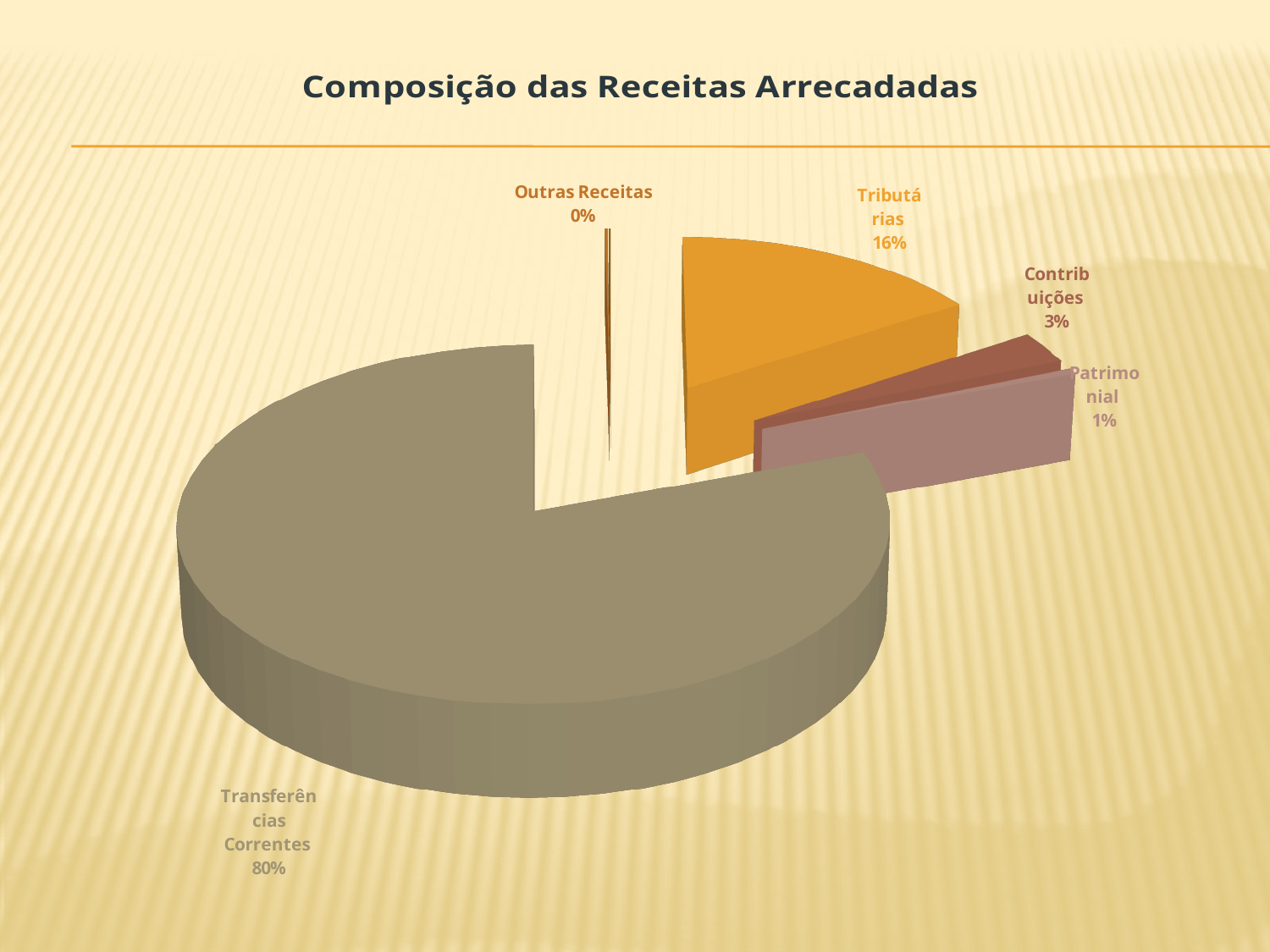
What share of the pie does Tributárias represent? 16% What kind of chart is shown on the slide? Pie chart What share of the pie does Contribuições represent? 3% Which is larger, the share for Contribuições or the share for Patrimonial? Contribuições How many categories are shown in the pie chart? 5 Which category has the largest slice of the pie? Transferências Correntes Which category has the smallest slice of the pie? Outras Receitas What share of the pie does Transferências Correntes represent? 80% What is the difference in percentage points between Transferências Correntes and Tributárias? 64 percentage points What is the title of the chart? Composição das Receitas Arrecadadas